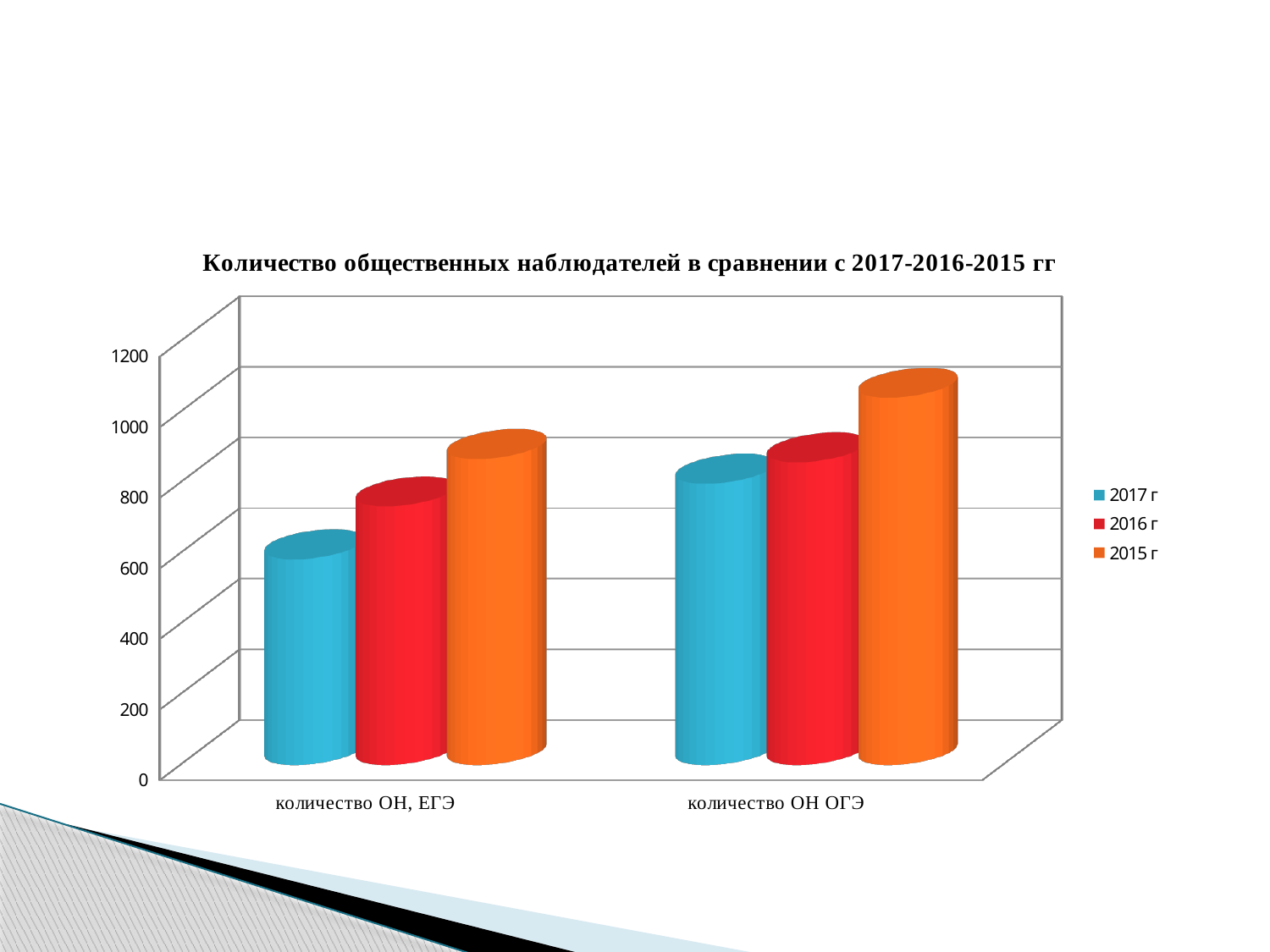
Which series is shown in orange in the legend? 2015 г How many categories are shown on the x axis? 2 Is the value for 2017 г in the category "количество ОН, ЕГЭ" greater or less than 800? less Which series has the highest value in the category "количество ОН, ЕГЭ"? 2015 г Is the value for 2015 г in the category "количество ОН, ЕГЭ" greater or less than 800? greater For the series 2015 г, which category has the larger value: "количество ОН, ЕГЭ" or "количество ОН ОГЭ"? количество ОН ОГЭ What kind of chart is shown on the slide? bar chart Is the value for 2017 г in the category "количество ОН ОГЭ" greater or less than 1000? less What is the title of the chart? Количество общественных наблюдателей в сравнении с 2017-2016-2015 гг How many series does the legend list? 3 Which series has the lowest value in the category "количество ОН, ЕГЭ"? 2017 г